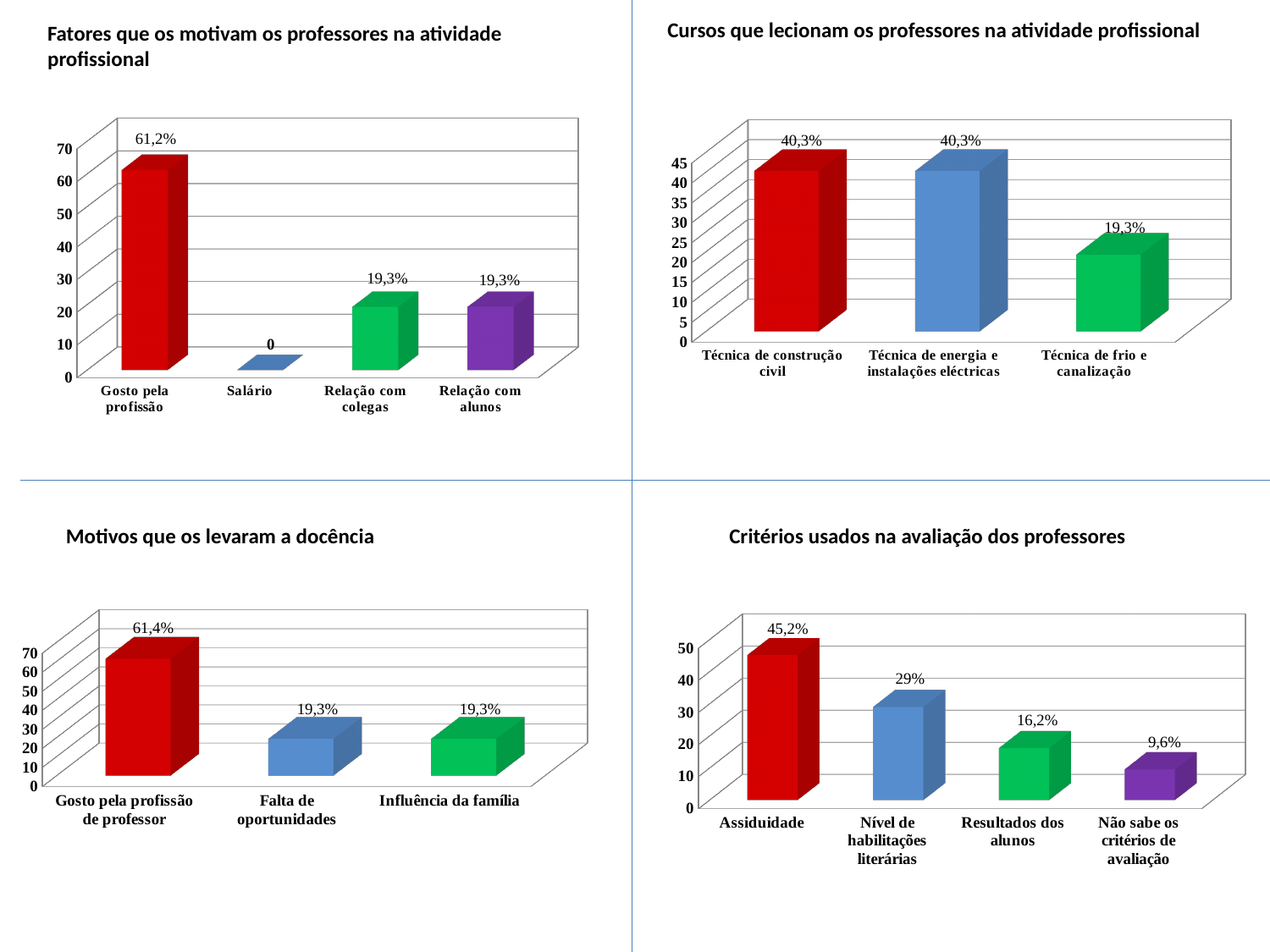
In the chart titled "Critérios usados na avaliação dos professores", which is larger: "Resultados dos alunos" or "Não sabe os critérios de avaliação"? Resultados dos alunos In the chart titled "Motivos que os levaram a docência", what is the value for "Falta de oportunidades"? 19,3% In the chart titled "Motivos que os levaram a docência", which category has the highest value? Gosto pela profissão de professor In the chart titled "Cursos que lecionam os professores na atividade profissional", what is the difference between "Técnica de construção civil" and "Técnica de frio e canalização"? 21 percentage points In the chart titled "Cursos que lecionam os professores na atividade profissional", what kind of chart is shown? Bar chart In the chart titled "Cursos que lecionam os professores na atividade profissional", what is the value for "Técnica de frio e canalização"? 19,3% In the chart titled "Fatores que os motivam os professores na atividade profissional", what is the value for "Gosto pela profissão"? 61,2% In the chart titled "Critérios usados na avaliação dos professores", what is the value for "Nível de habilitações literárias"? 29% In the chart titled "Fatores que os motivam os professores na atividade profissional", how many categories are shown? 4 In the chart titled "Fatores que os motivam os professores na atividade profissional", which category has the lowest value? Salário In the chart titled "Motivos que os levaram a docência", how many categories are shown? 3 In the chart titled "Critérios usados na avaliação dos professores", do the values rise or fall from left to right along the x axis? Fall